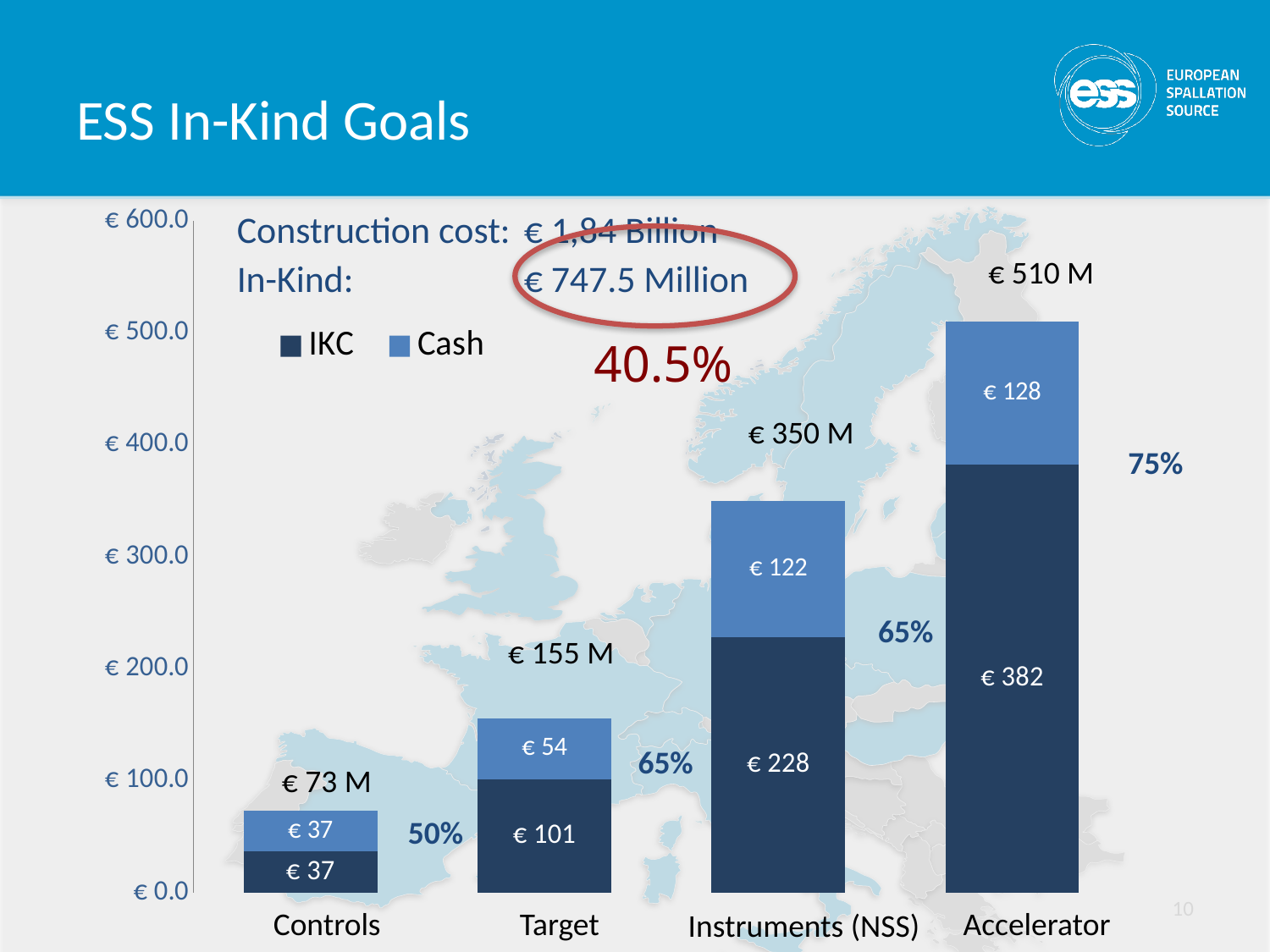
What is the difference between the IKC values for Accelerator and Instruments (NSS)? € 154 How many categories are shown on the x axis? 4 Which category has the highest total bar? Accelerator What kind of chart is shown on the slide? Stacked bar chart What is the sum of the IKC and Cash values for Controls? € 73 What is the IKC value for Accelerator? € 382 Which is larger, the Cash value for Instruments (NSS) or the Cash value for Accelerator? Accelerator Which category has the lowest total bar? Controls Is the total for Target greater or less than € 200.0? less How many series does the legend list? 2 What is the Cash value for Target? € 54 What is the total labelled above the Instruments (NSS) bar? € 350 M